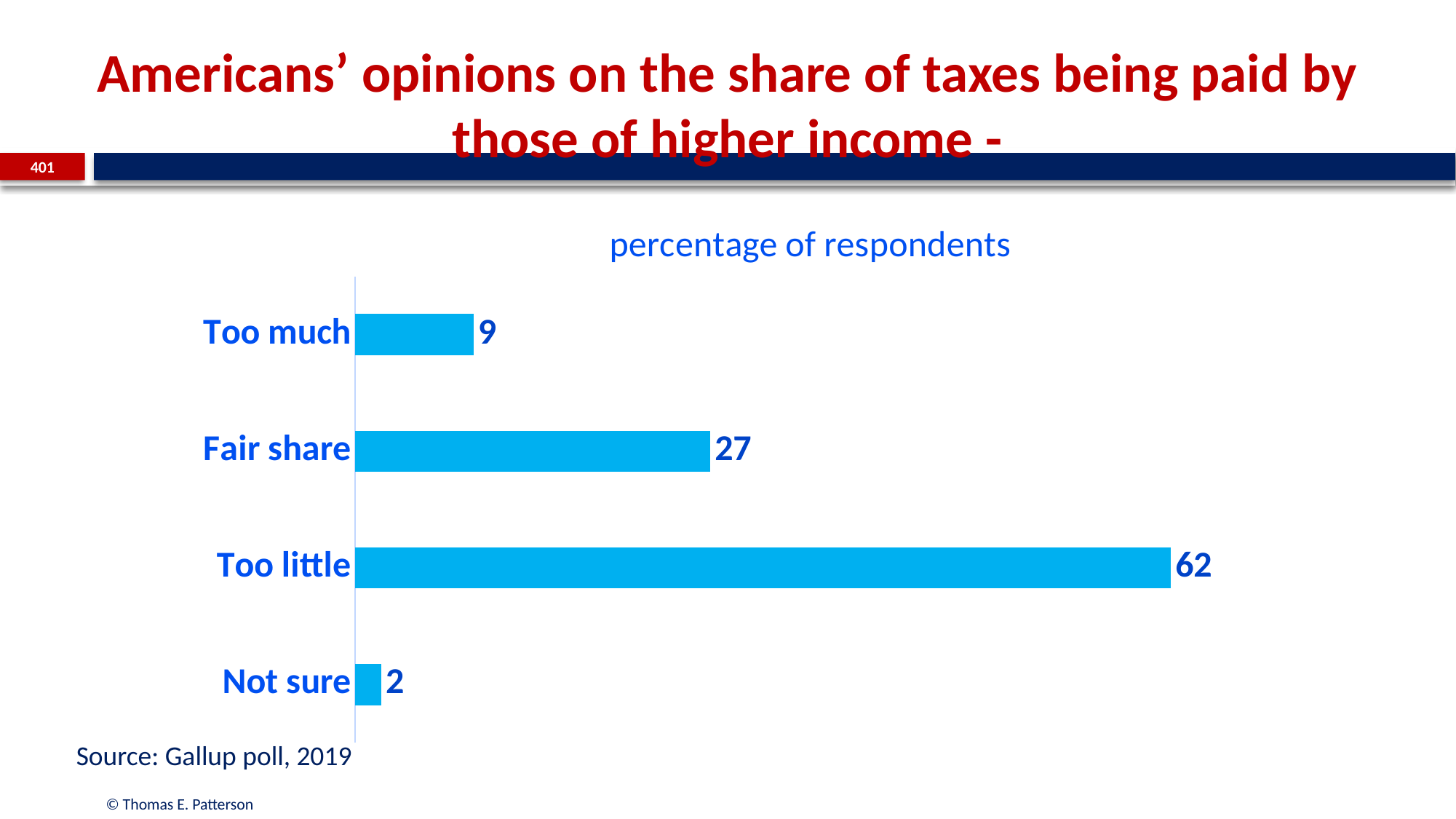
What is the value for the 'Too much' category? 9 What kind of chart is shown on the slide? Bar chart What is the difference between the values for 'Too much' and 'Not sure'? 7 How many categories are shown in the chart? 4 What is the difference between the values for 'Too little' and 'Fair share'? 35 Which is larger, the value for 'Fair share' or the value for 'Too much'? Fair share Which category has the highest value? Too little What is the source cited for the chart data? Gallup poll, 2019 What percentage of respondents said those of higher income pay too little in taxes? 62 What is the value for the 'Fair share' category? 27 Which category has the lowest value? Not sure What is the value for the 'Not sure' category? 2